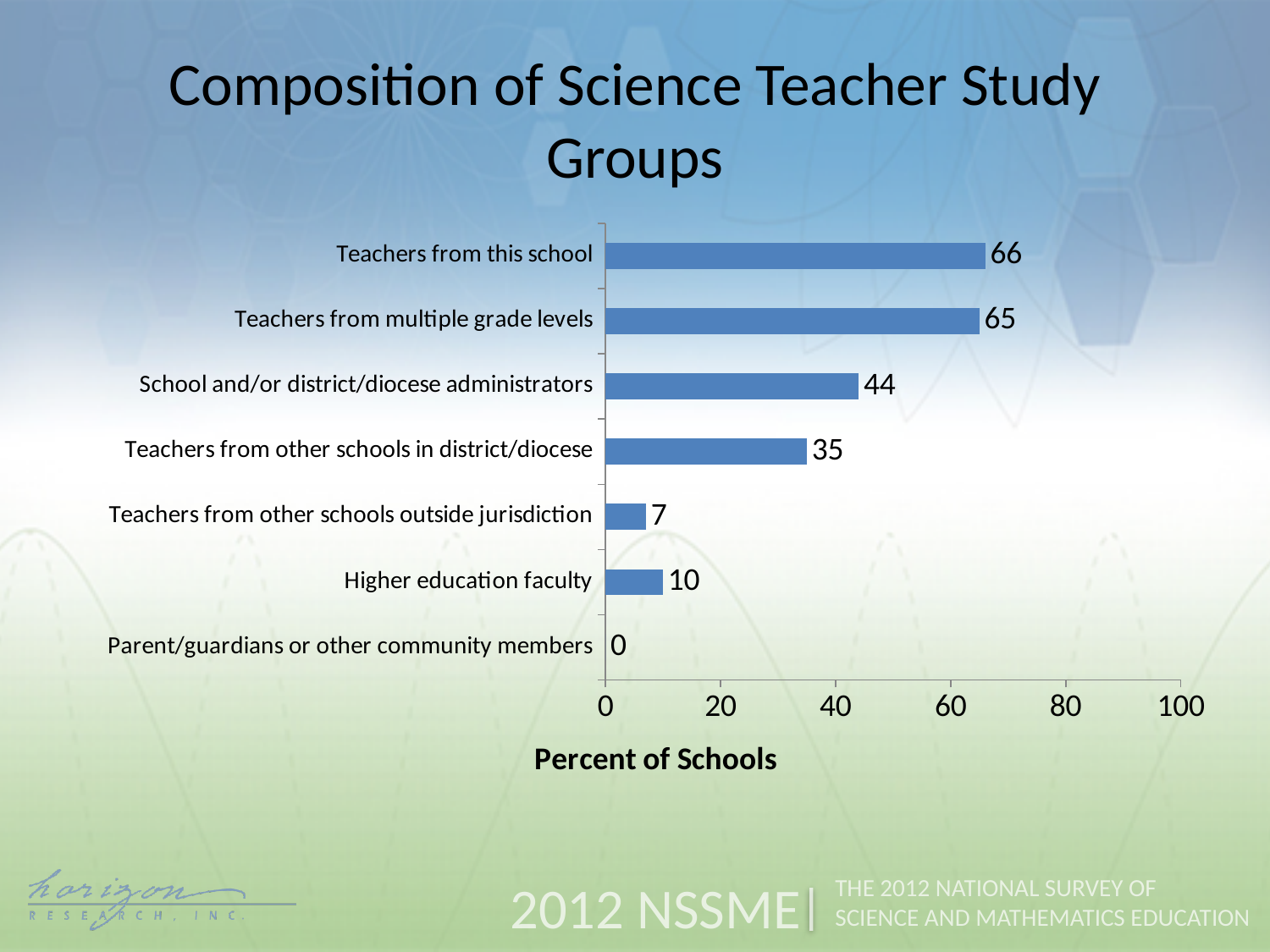
What is the label on the horizontal axis of the chart? Percent of Schools Which category has the highest value? Teachers from this school What kind of chart is shown on the slide? Bar chart What is the value for School and/or district/diocese administrators? 44 What is the value for Higher education faculty? 10 How many categories are shown in the chart? 7 What percent of schools have teachers from this school in their science teacher study groups? 66 Which category has the lowest value? Parent/guardians or other community members Which is larger: the value for Higher education faculty or the value for Teachers from other schools outside jurisdiction? Higher education faculty Is the value for Teachers from multiple grade levels greater or less than 60? greater What is the difference between the values for Teachers from this school and Teachers from other schools in district/diocese? 31 What is the value for Parent/guardians or other community members? 0